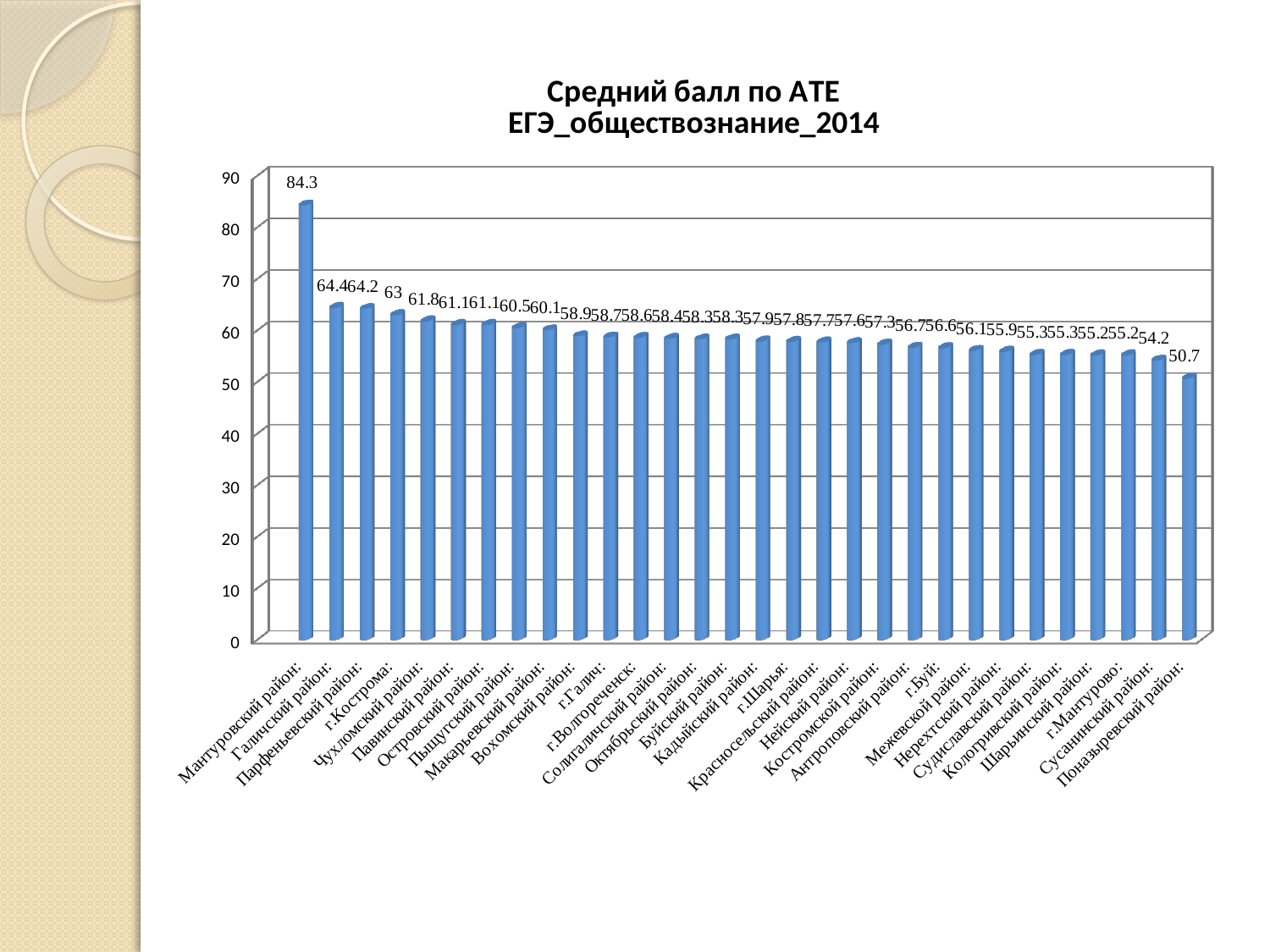
How many districts are shown on the chart? 30 Which has a higher average score, г.Кострома or Чухломский район? г.Кострома Which district has the lowest average score? Поназыревский район What is the difference between the scores of Мантуровский район and Поназыревский район? 33.6 Is the value for Сусанинский район greater or less than 60? less What is the average score for Поназыревский район? 50.7 Do the values generally rise or fall from left to right along the x axis? fall What is the average score for Мантуровский район? 84.3 By how much does Галичский район exceed Парфеньевский район? 0.2 What is the value shown for г.Кострома? 63 Which district has the highest average score? Мантуровский район What type of chart is shown on the slide? bar chart